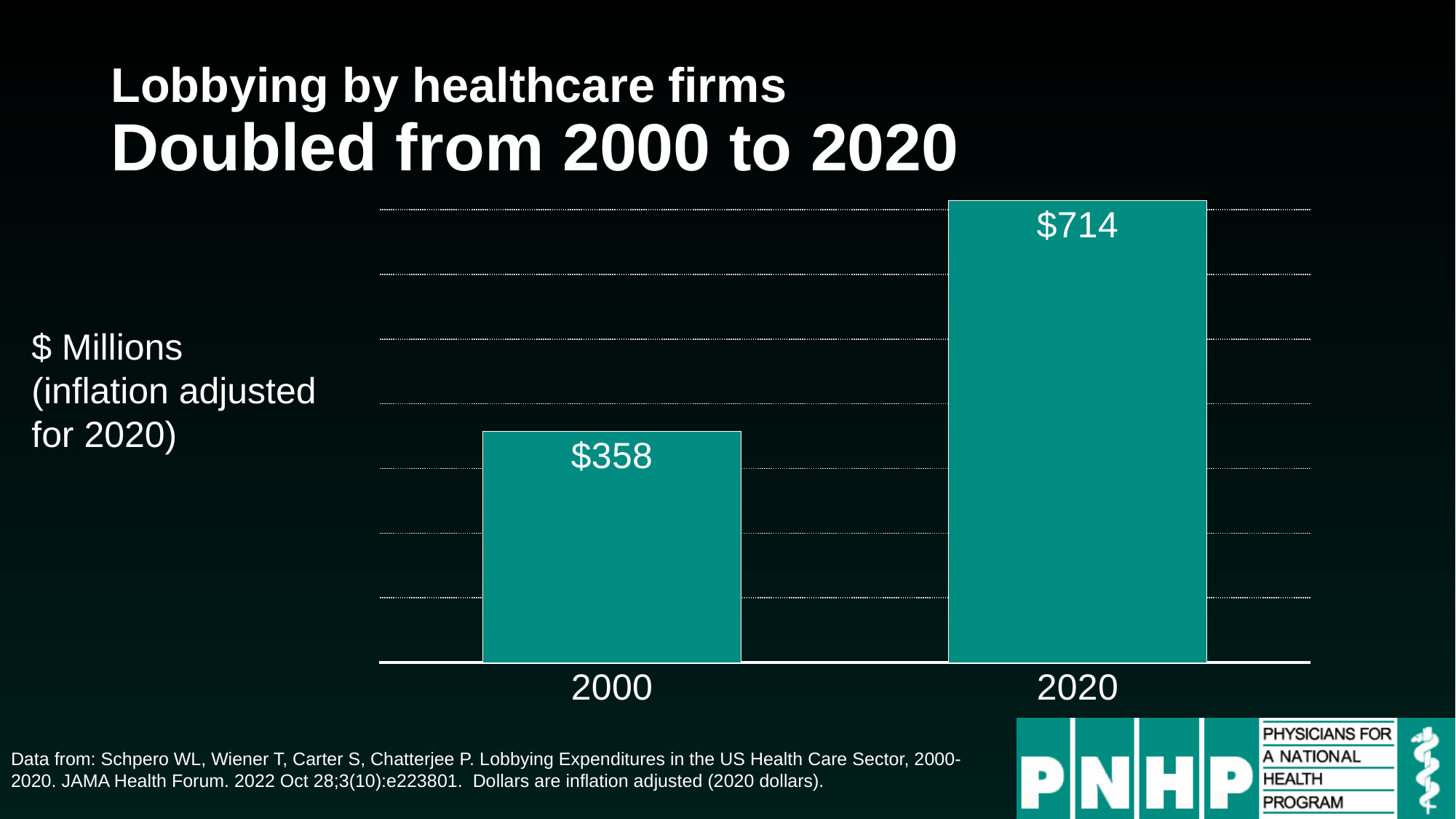
What colour are the bars in the chart? Teal What is the difference between the 2020 value and the 2000 value? $356 What unit are the values in, according to the label on the left of the chart? $ Millions (inflation adjusted for 2020) How many bars are shown in the chart? 2 What is the value for 2020? $714 What is the value for 2000? $358 Do the values rise or fall from 2000 to 2020? Rise Which year has the lower value? 2000 What kind of chart is shown on the slide? Bar chart Which year has the higher value? 2020 Is the value for 2020 larger than the value for 2000? Yes